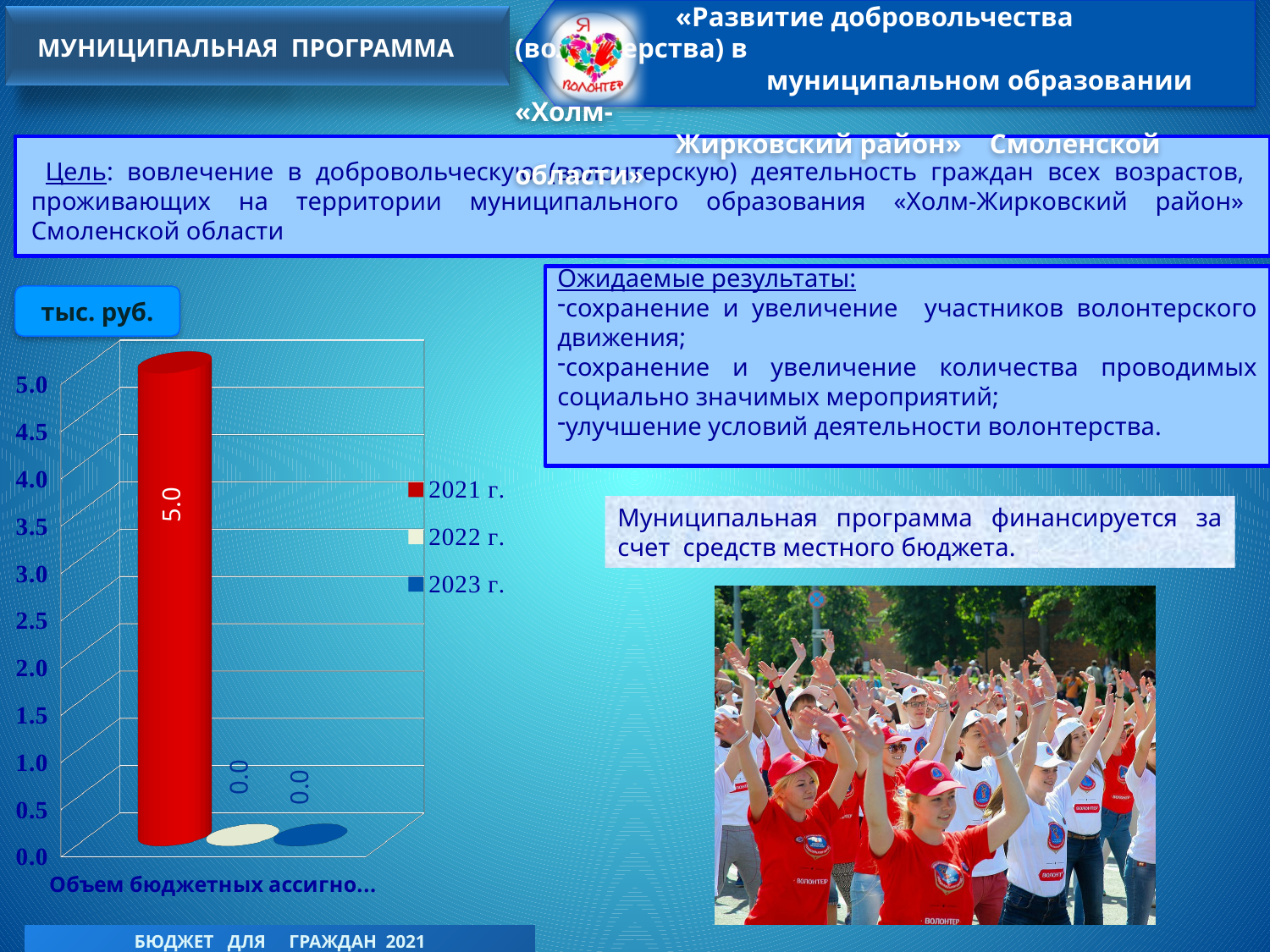
What kind of chart is shown on the slide? bar chart What unit is shown in the label above the chart? тыс. руб. What is the difference between the values for 2021 г. and 2022 г.? 5.0 What colour is the bar for 2021 г. in the chart? red What is the value for 2021 г. in the chart? 5.0 Is the value for 2021 г. greater or less than 4.0? greater Which year has the highest value in the chart? 2021 г. What is the value for 2022 г. in the chart? 0.0 Which is larger, the value for 2021 г. or the value for 2023 г.? 2021 г. How many series does the chart legend list? 3 What is the total of the values for 2021 г., 2022 г. and 2023 г.? 5.0 What is the value for 2023 г. in the chart? 0.0